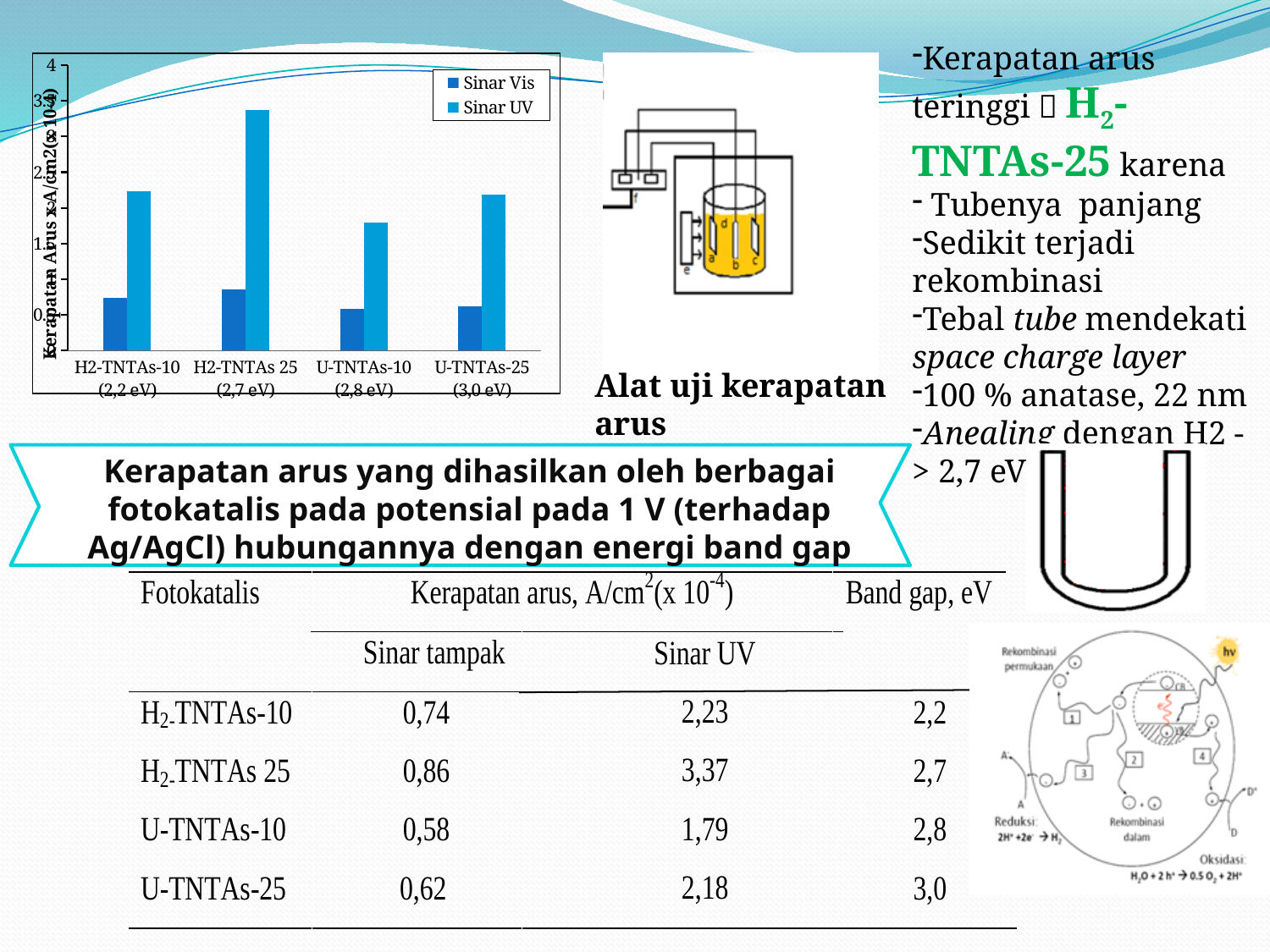
For U-TNTAs-25, which series has the larger bar, Sinar Vis or Sinar UV? Sinar UV Is the Sinar UV value for H2-TNTAs 25 greater or less than 3? greater What kind of chart is shown on the slide? bar chart Is the Sinar UV value for U-TNTAs-10 greater or less than 2? less According to the table on the slide, what is the Sinar UV current density for H2-TNTAs 25? 3,37 Which category has the highest Sinar Vis bar in the chart? H2-TNTAs 25 (2,7 eV) How many photocatalyst categories are shown on the x axis of the chart? 4 Which category has the lowest Sinar UV bar in the chart? U-TNTAs-10 (2,8 eV) How many series does the chart legend list? 2 Which category has the highest Sinar UV bar in the chart? H2-TNTAs 25 (2,7 eV) What are the two series named in the chart legend? Sinar Vis and Sinar UV Is the Sinar Vis value for U-TNTAs-10 greater or less than 0.5? greater